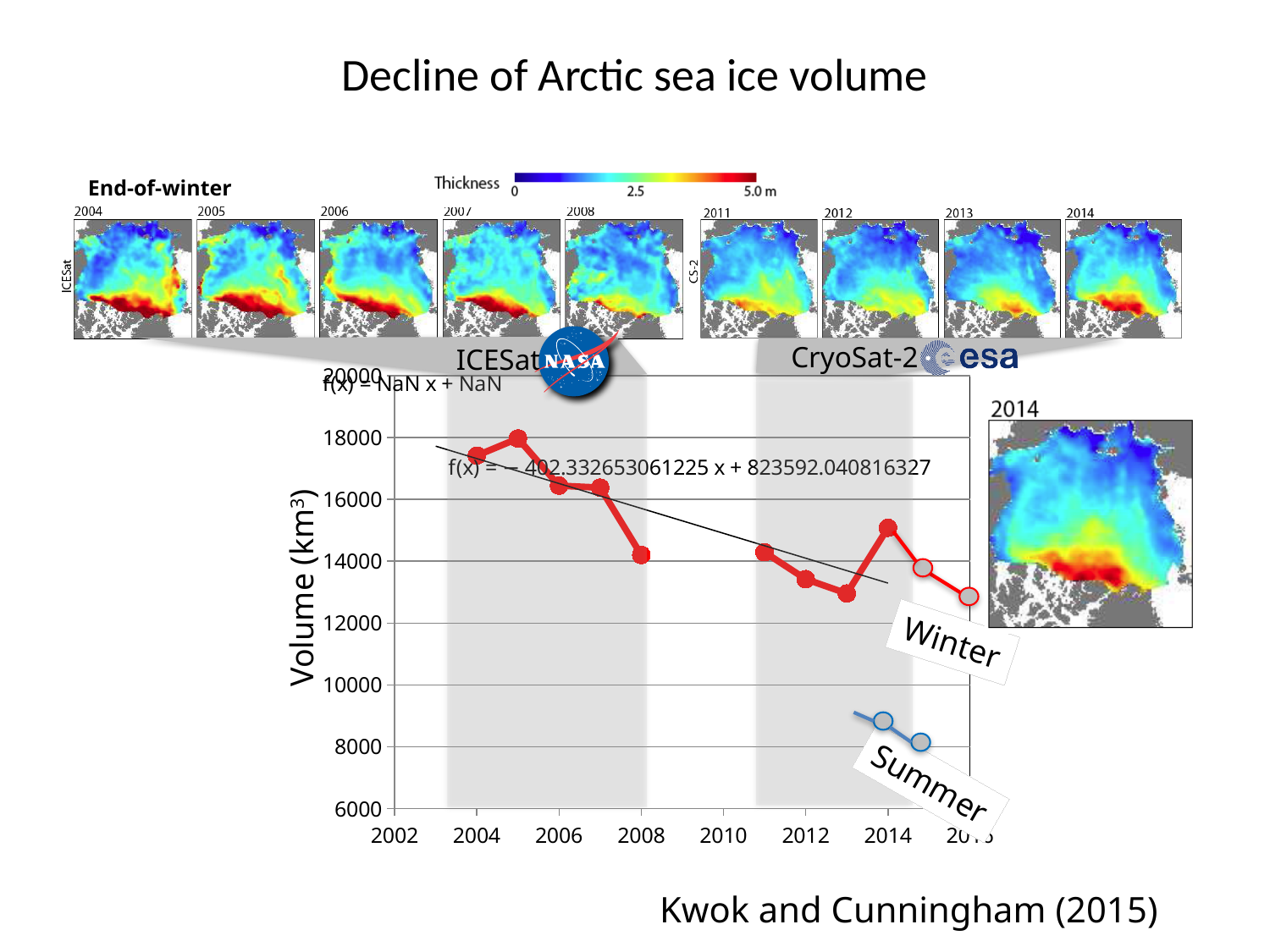
Which of the two Summer points has the lower volume, 2014 or 2015? 2015 Overall, do the Winter sea ice volume values rise or fall from 2004 to 2016? fall Which is larger, the Winter volume in 2012 or the Winter volume in 2014? 2014 Is the Winter volume for 2005 greater or less than 16000 km³? greater Is the Winter volume for 2008 greater or less than 16000 km³? less Is the Winter volume for 2013 greater or less than 14000 km³? less What is the title of the slide containing the sea ice volume chart? Decline of Arctic sea ice volume What is the label on the y axis of the sea ice volume chart? Volume (km³) In which year is the Winter sea ice volume highest? 2005 What kind of chart is used to show Arctic sea ice volume on the slide? line chart How many Summer data points are plotted on the chart? 2